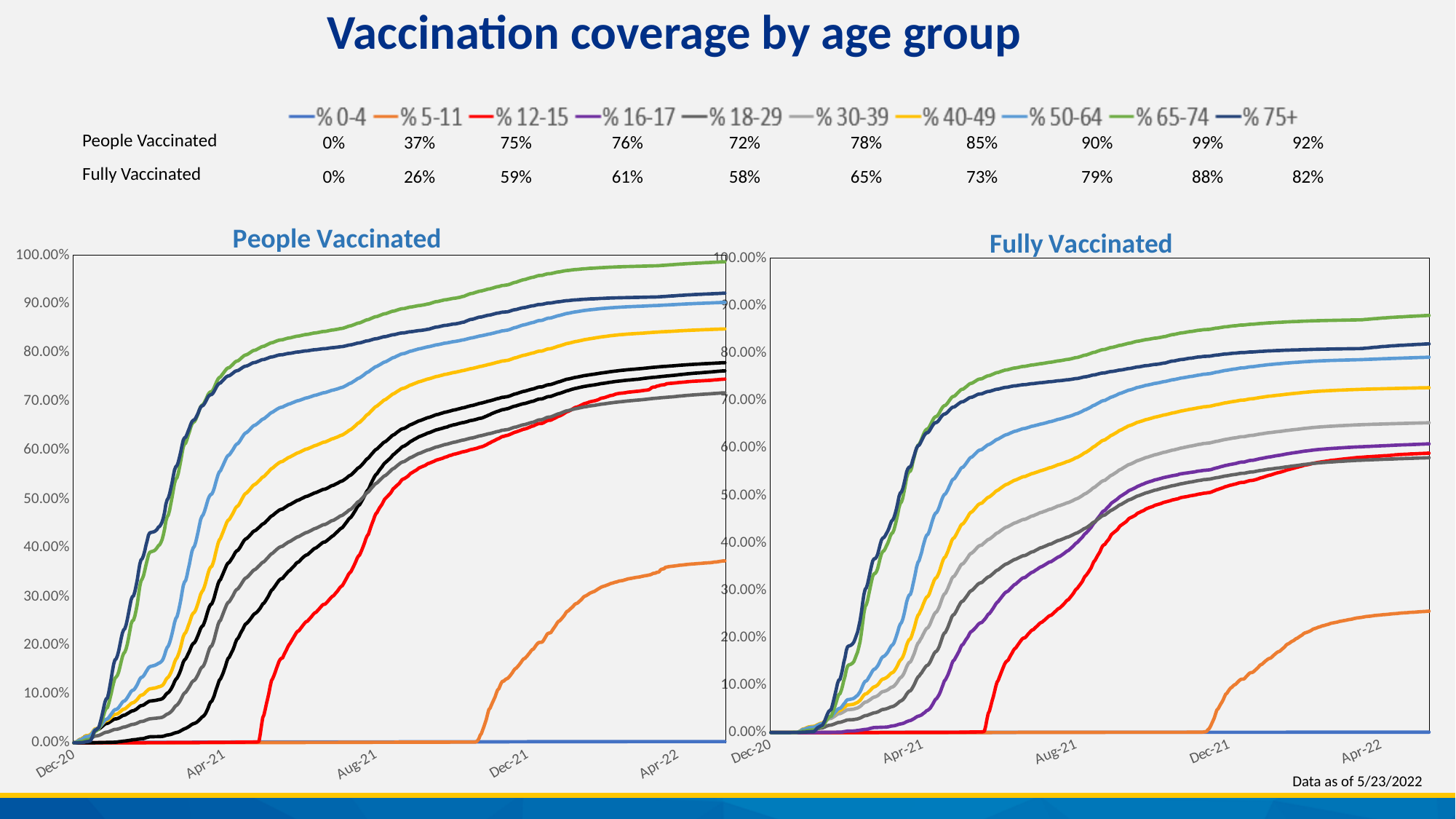
Which age group has the highest People Vaccinated value? 65-74 According to the table, what is the Fully Vaccinated value for the 5-11 age group? 26% Which age group has the lowest Fully Vaccinated value? 0-4 How many age-group series does the legend list? 10 According to the table, what is the People Vaccinated value for the 50-64 age group? 90% What is the title of the slide? Vaccination coverage by age group What kind of chart is the People Vaccinated chart? Line chart For the 75+ age group, what is the difference between the People Vaccinated value and the Fully Vaccinated value? 10 percentage points In the People Vaccinated chart, do the lines generally rise or fall from Dec-20 to Apr-22? Rise In the Fully Vaccinated chart, is the value for the 5-11 line at Apr-22 greater or less than 30.00%? less According to the table, what is the People Vaccinated value for the 65-74 age group? 99% Which age group has the larger Fully Vaccinated value, 16-17 or 18-29? 16-17